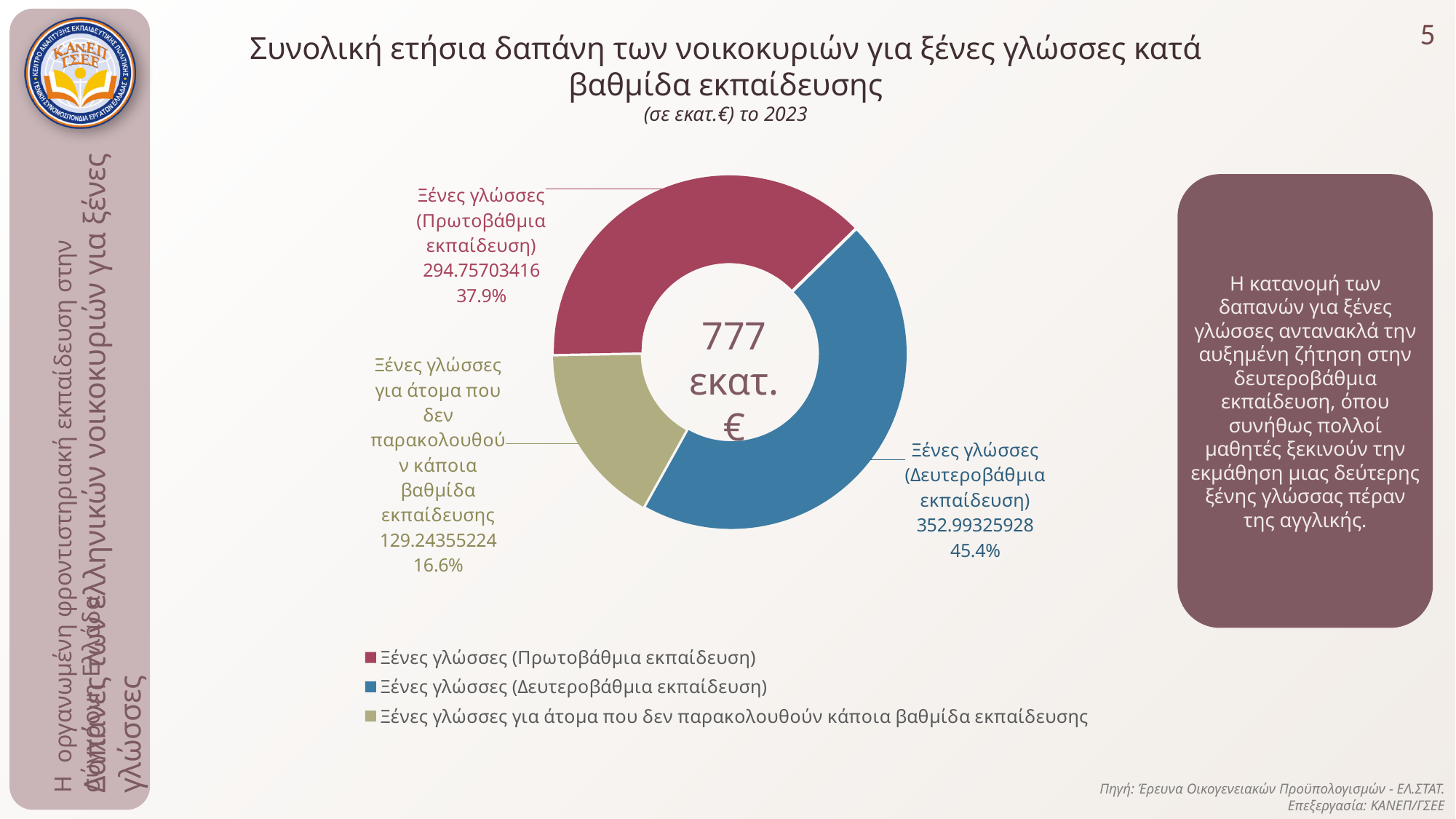
What is the difference in percentage share between Ξένες γλώσσες (Δευτεροβάθμια εκπαίδευση) and Ξένες γλώσσες (Πρωτοβάθμια εκπαίδευση)? 7.5 percentage points What is the value for Ξένες γλώσσες για άτομα που δεν παρακολουθούν κάποια βαθμίδα εκπαίδευσης? 129.24355224 What is the value for Ξένες γλώσσες (Δευτεροβάθμια εκπαίδευση)? 352.99325928 What is the value for Ξένες γλώσσες (Πρωτοβάθμια εκπαίδευση)? 294.75703416 What kind of chart is shown on the slide? Doughnut (pie) chart Which is larger, the value for Ξένες γλώσσες (Πρωτοβάθμια εκπαίδευση) or for Ξένες γλώσσες για άτομα που δεν παρακολουθούν κάποια βαθμίδα εκπαίδευσης? Ξένες γλώσσες (Πρωτοβάθμια εκπαίδευση) What total is shown in the centre of the chart? 777 εκατ. € Which category has the highest value? Ξένες γλώσσες (Δευτεροβάθμια εκπαίδευση) Which category has the lowest value? Ξένες γλώσσες για άτομα που δεν παρακολουθούν κάποια βαθμίδα εκπαίδευσης What share of the chart does Ξένες γλώσσες (Πρωτοβάθμια εκπαίδευση) represent? 37.9% What share of the chart does Ξένες γλώσσες για άτομα που δεν παρακολουθούν κάποια βαθμίδα εκπαίδευσης represent? 16.6% How many categories does the chart show? 3